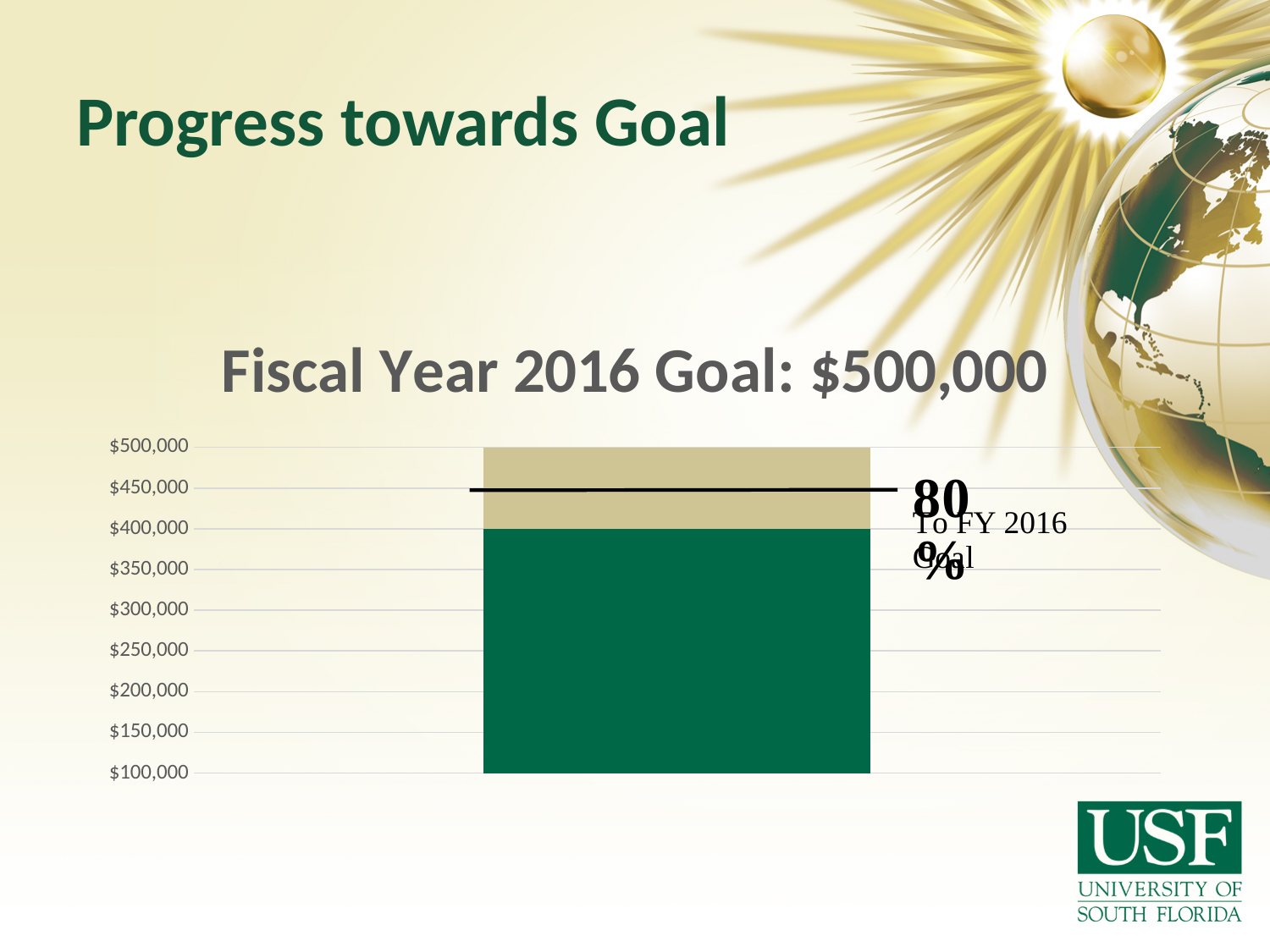
What is the title of the chart? Fiscal Year 2016 Goal: $500,000 Is the value of the green segment greater or less than $350,000? greater What is the lowest value shown on the y axis? $100,000 What value does the top of the green segment of the bar reach on the y axis? $400,000 Is the value of the green segment greater or less than $450,000? less What is the highest value shown on the y axis? $500,000 Which segment of the bar is taller, the green segment or the tan segment? green How many bars are plotted in the chart? 1 What percentage of the FY 2016 goal has been reached, according to the label next to the bar? 80% What is the total height of the stacked bar (top of the tan segment)? $500,000 What kind of chart is shown on the slide? bar chart